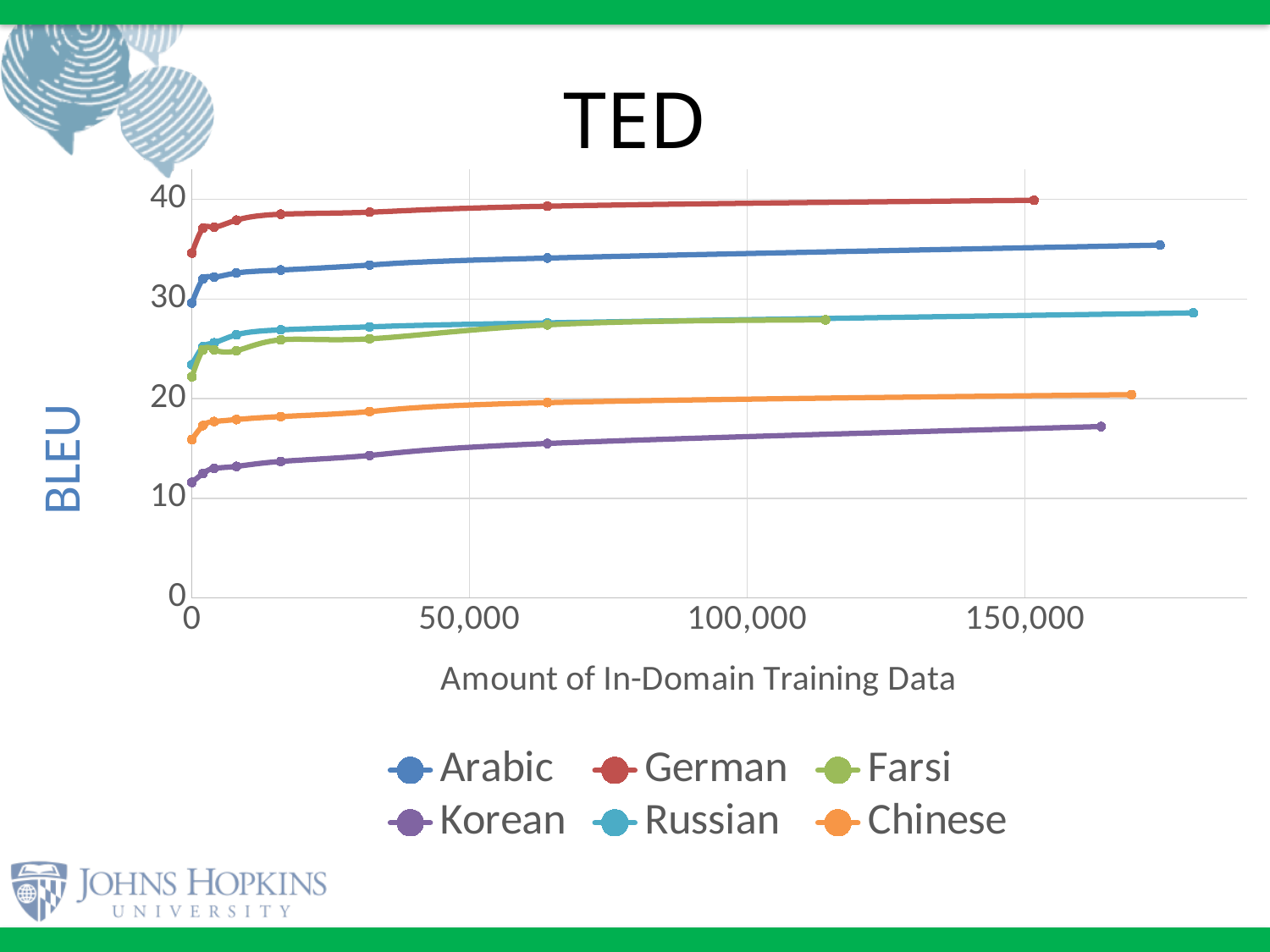
What is the label of the y axis? BLEU What is the title of the chart? TED Is the BLEU value for German at 50,000 training examples greater or less than 30? greater Which series has the higher BLEU score at 100,000 training examples, Arabic or Chinese? Arabic What kind of chart is shown on the slide? line chart Is the BLEU value for Chinese at 50,000 training examples greater or less than 20? less How many series does the legend list? 6 Is the BLEU value for Korean at its rightmost point greater or less than 20? less Which language series has the highest BLEU scores across the chart? German Do the BLEU scores rise or fall as the amount of in-domain training data increases? rise Which language series has the lowest BLEU scores across the chart? Korean